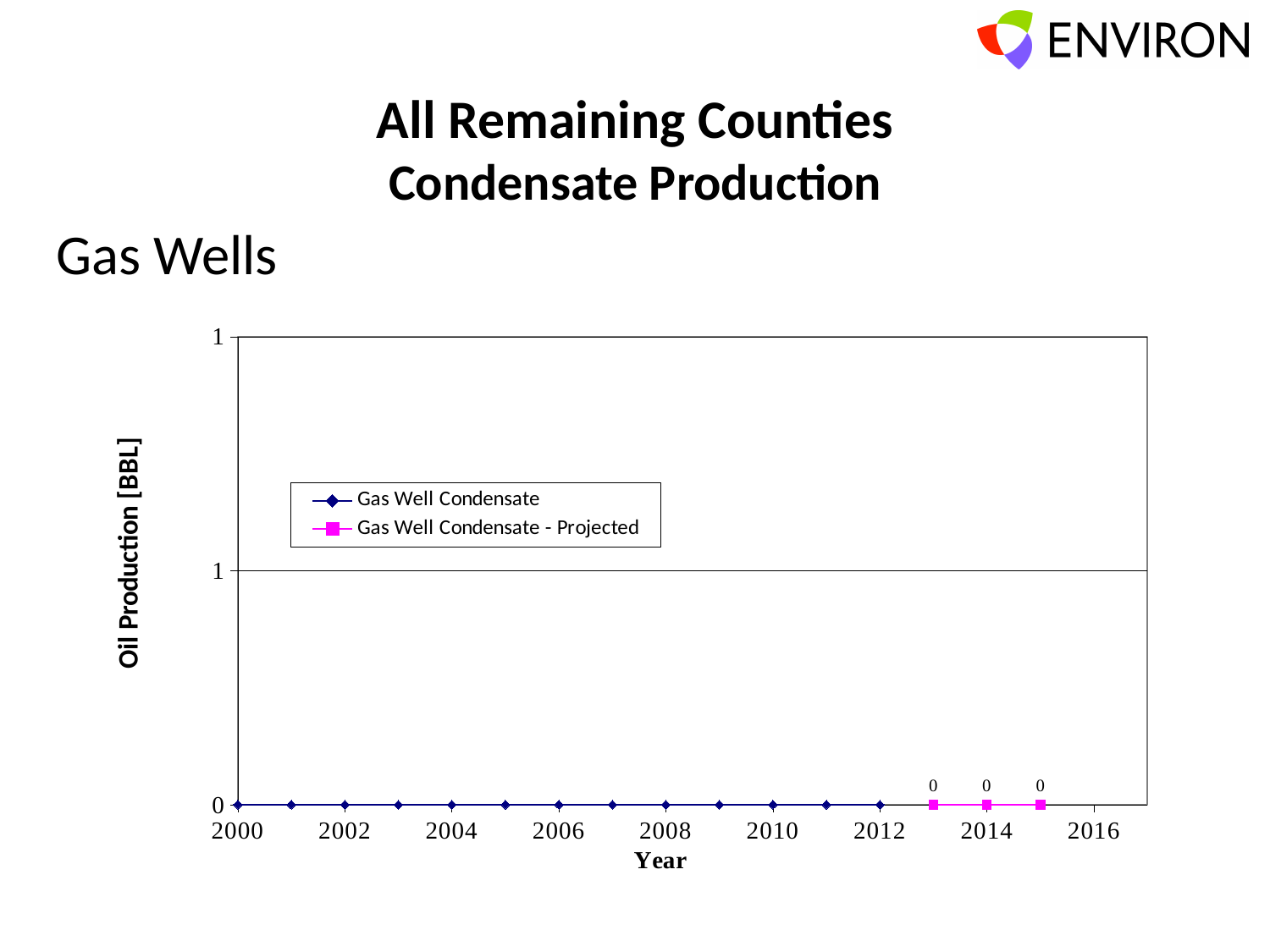
What is the projected Gas Well Condensate value for 2014? 0 Does the Gas Well Condensate series rise, fall, or stay flat from 2000 to 2012? stays flat What kind of chart is shown on the slide? line chart What is the title of the y axis? Oil Production [BBL] What is the Gas Well Condensate value for 2000? 0 What is the projected Gas Well Condensate value for 2013? 0 What is the projected Gas Well Condensate value for 2015? 0 How many data points does the Gas Well Condensate - Projected series have? 3 What is the second entry in the legend? Gas Well Condensate - Projected How many data points does the Gas Well Condensate series have? 13 How many series does the legend list? 2 Is the Gas Well Condensate value for 2010 greater or less than 1? less